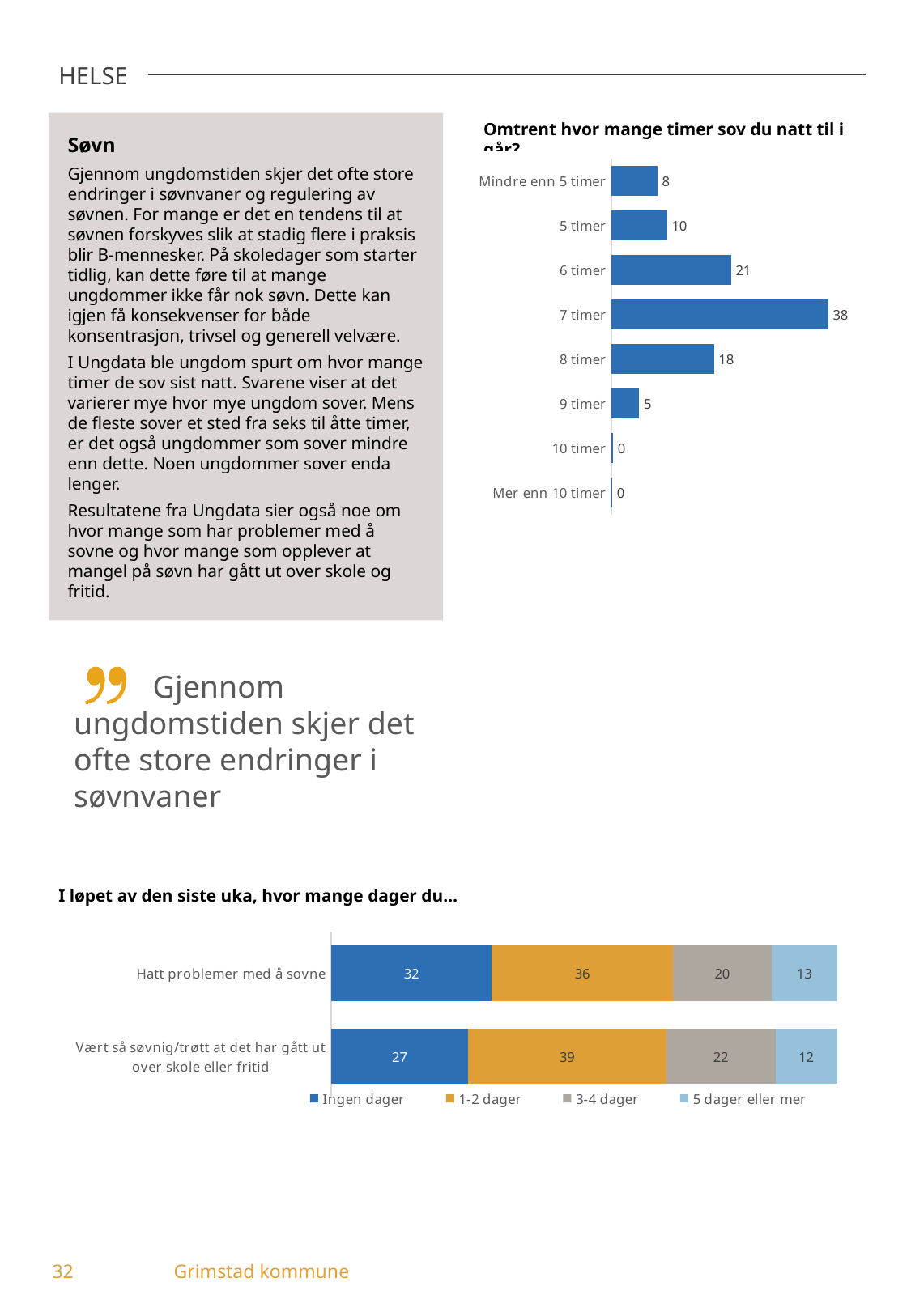
In the bottom chart "I løpet av den siste uka, hvor mange dager du…", what is the total of the "Hatt problemer med å sovne" bar? 101 In the top-right chart about hours of sleep, what is the difference between the values for "6 timer" and "8 timer"? 3 In the top-right chart about hours of sleep, what is the value for "Mindre enn 5 timer"? 8 What kind of chart is the top-right chart about hours of sleep? Bar chart In the top-right chart about hours of sleep, which is larger: the value for "5 timer" or the value for "9 timer"? 5 timer In the bottom chart "I løpet av den siste uka, hvor mange dager du…", what is the value for "Ingen dager" in the "Vært så søvnig/trøtt at det har gått ut over skole eller fritid" bar? 27 In the bottom chart "I løpet av den siste uka, hvor mange dager du…", what is the value for "1-2 dager" in the "Hatt problemer med å sovne" bar? 36 In the bottom chart "I løpet av den siste uka, hvor mange dager du…", which colour represents "3-4 dager"? Grey In the top-right chart about hours of sleep, which category has the highest value? 7 timer How many series does the legend list in the bottom chart "I løpet av den siste uka, hvor mange dager du…"? 4 How many categories are shown in the top-right chart about hours of sleep? 8 In the top-right chart about hours of sleep, what is the value for "7 timer"? 38